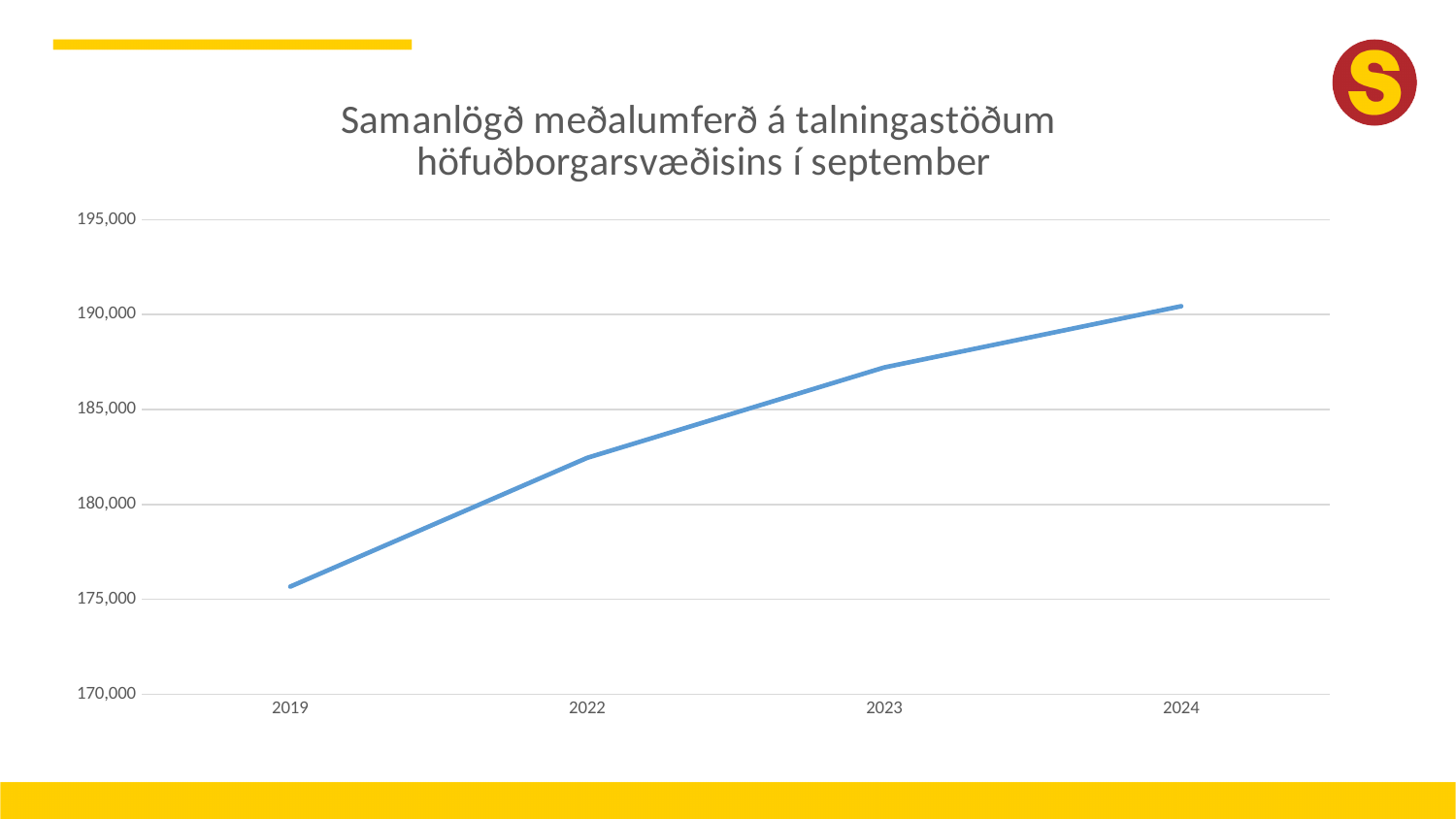
Is the value for 2023 greater or less than 185,000? greater What is the title of the chart? Samanlögð meðalumferð á talningastöðum höfuðborgarsvæðisins í september Is the value for 2022 greater or less than 185,000? less What kind of chart is shown on the slide? line chart How many years are plotted on the x axis of the chart? 4 Is the value for 2024 greater or less than 195,000? less Do the values rise or fall from 2019 to 2024? rise Which year has the highest value in the chart? 2024 Which is larger, the value for 2023 or the value for 2022? 2023 Which year has the lowest value in the chart? 2019